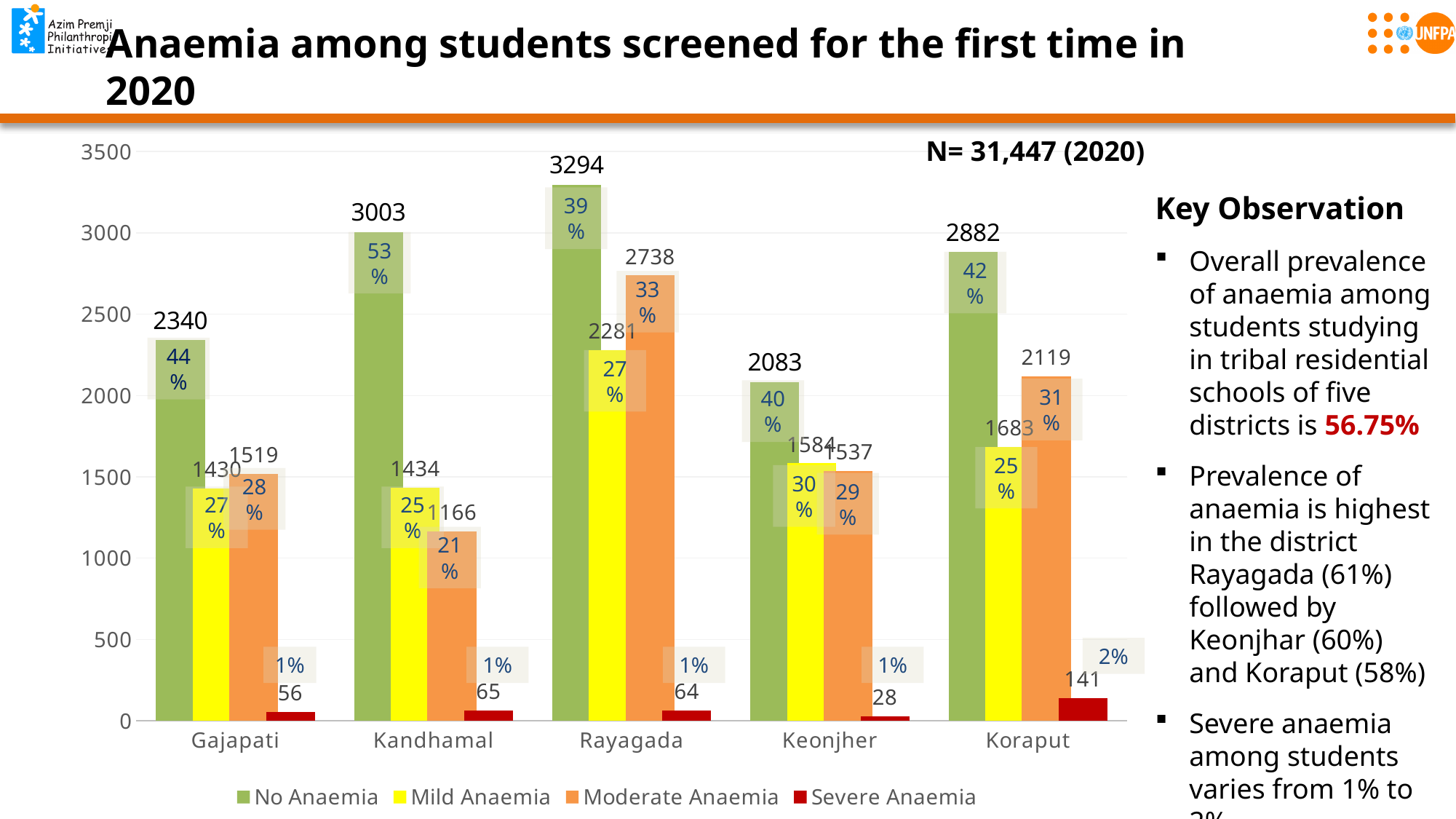
Which district has the highest No Anaemia value? Rayagada Which is larger for Rayagada: the Mild Anaemia value or the Moderate Anaemia value? Moderate Anaemia What is the N value stated on the slide for 2020? N= 31,447 (2020) How many series does the legend list? 4 What is the No Anaemia value for Rayagada? 3294 What is the Severe Anaemia value for Keonjher? 28 What percentage label is shown on the Mild Anaemia bar for Keonjher? 30% What is the Moderate Anaemia value for Koraput? 2119 What type of chart is shown on the slide? bar chart What is the difference between the No Anaemia values for Kandhamal and Gajapati? 663 Which district has the lowest Severe Anaemia value? Keonjher How many districts are shown on the x axis? 5